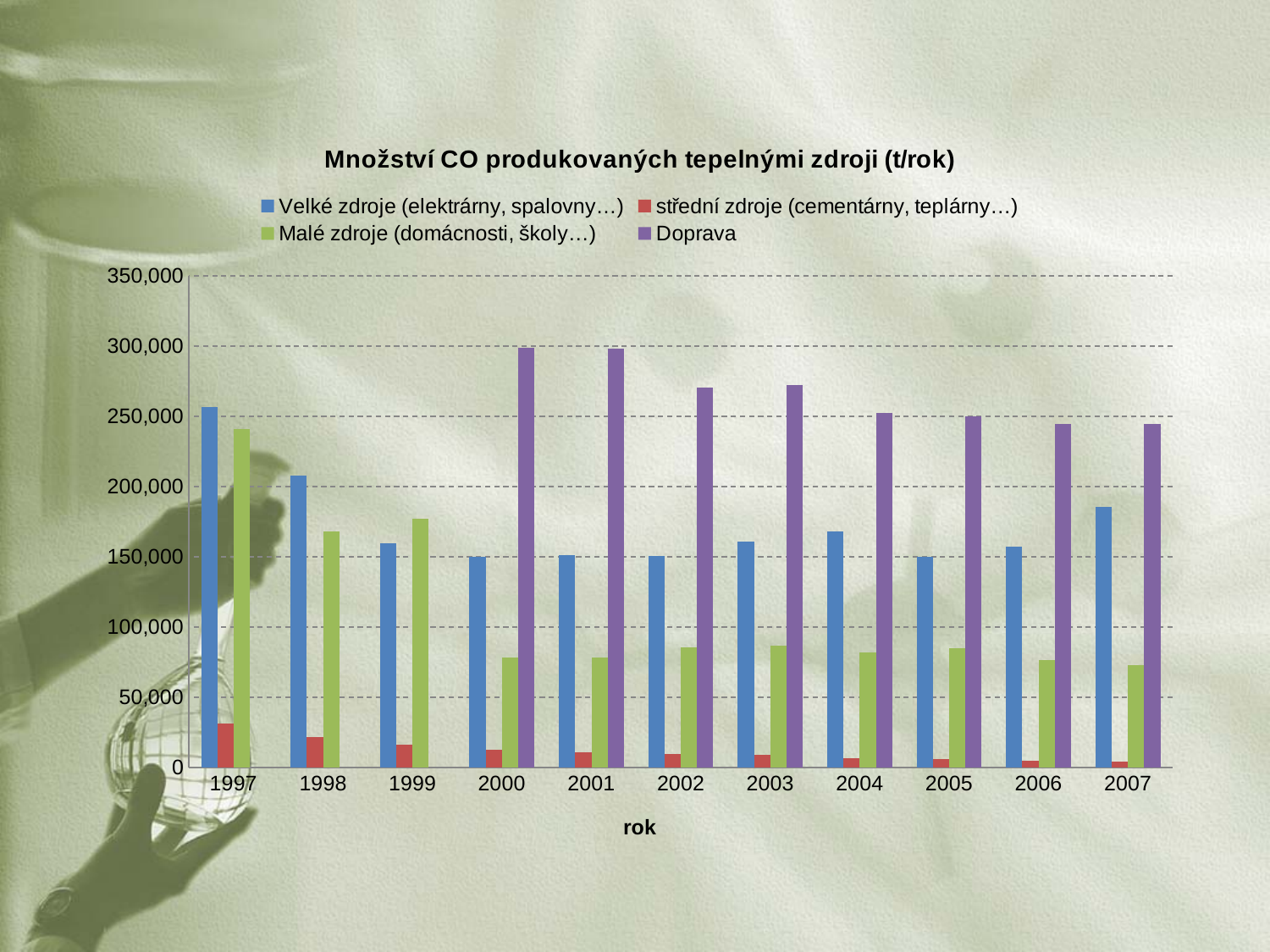
Is the value for Velké zdroje (elektrárny, spalovny…) in 1998 greater or less than 200,000? greater In 1999, which is larger: Malé zdroje (domácnosti, školy…) or Velké zdroje (elektrárny, spalovny…)? Malé zdroje (domácnosti, školy…) What kind of chart is shown on the slide? bar chart How many years are shown on the x axis? 11 Is the value for Malé zdroje (domácnosti, školy…) in 2007 greater or less than 100,000? less Is the value for Velké zdroje (elektrárny, spalovny…) in 1997 greater or less than 200,000? greater How many series does the legend list? 4 Do the values for střední zdroje (cementárny, teplárny…) rise or fall from 1997 to 2007? fall What is the title of the x axis? rok In which year is the value for Velké zdroje (elektrárny, spalovny…) highest? 1997 In 2000, which is larger: Doprava or Velké zdroje (elektrárny, spalovny…)? Doprava